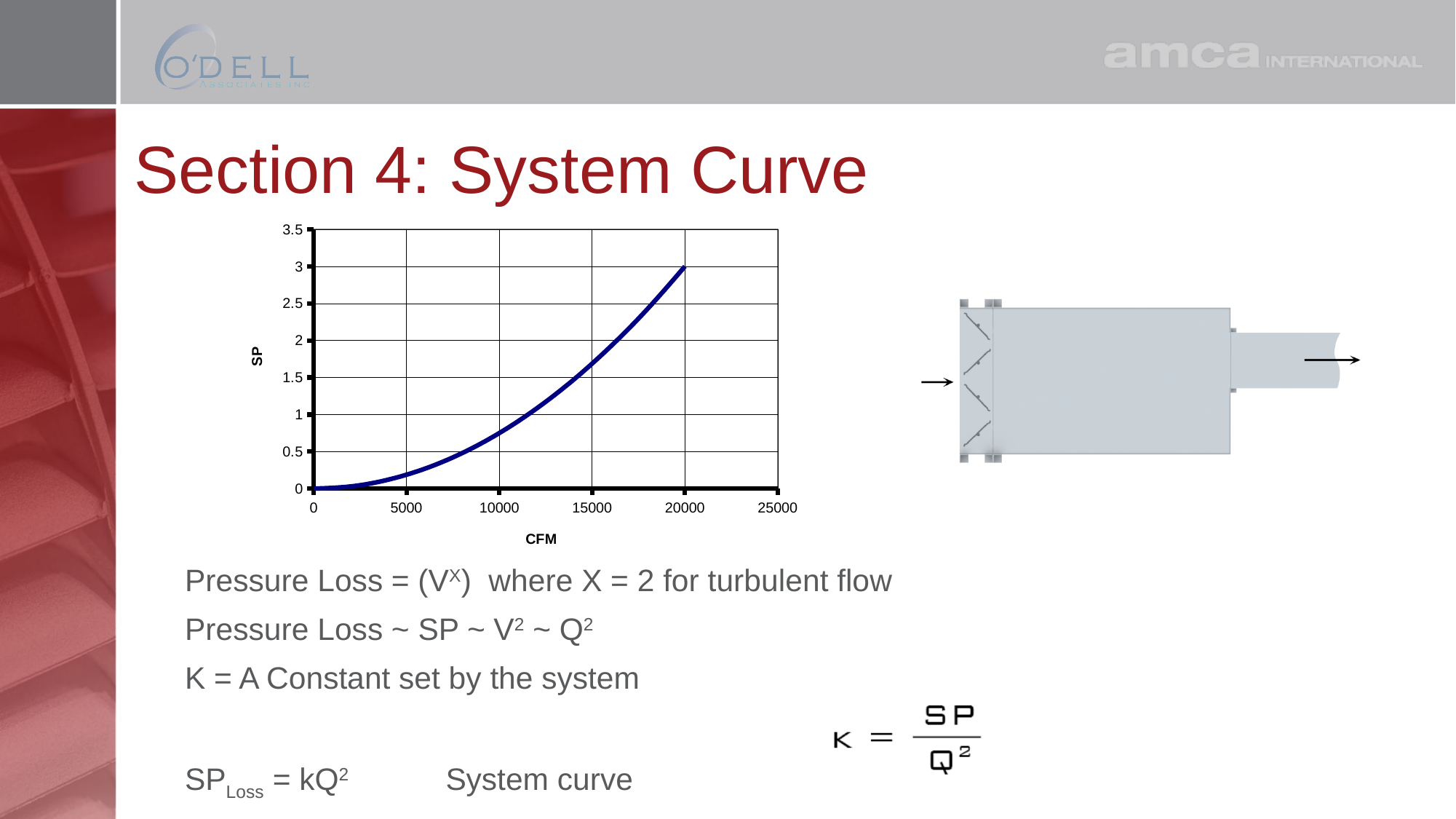
What is the SP value at 0 CFM? 0 What is the label of the y axis of the chart? SP Does the SP value rise or fall as CFM increases along the x axis? rise What kind of chart is shown on the slide? line chart What is the SP value where the curve ends at 20000 CFM? 3 How many curves are plotted on the chart? 1 What is the label of the x axis of the chart? CFM Is the SP value at 5000 CFM greater or less than 0.5? less Is the SP value at 10000 CFM greater or less than 1? less Which has the larger SP value, 10000 CFM or 15000 CFM? 15000 CFM Is the SP value at 15000 CFM greater or less than 2? less